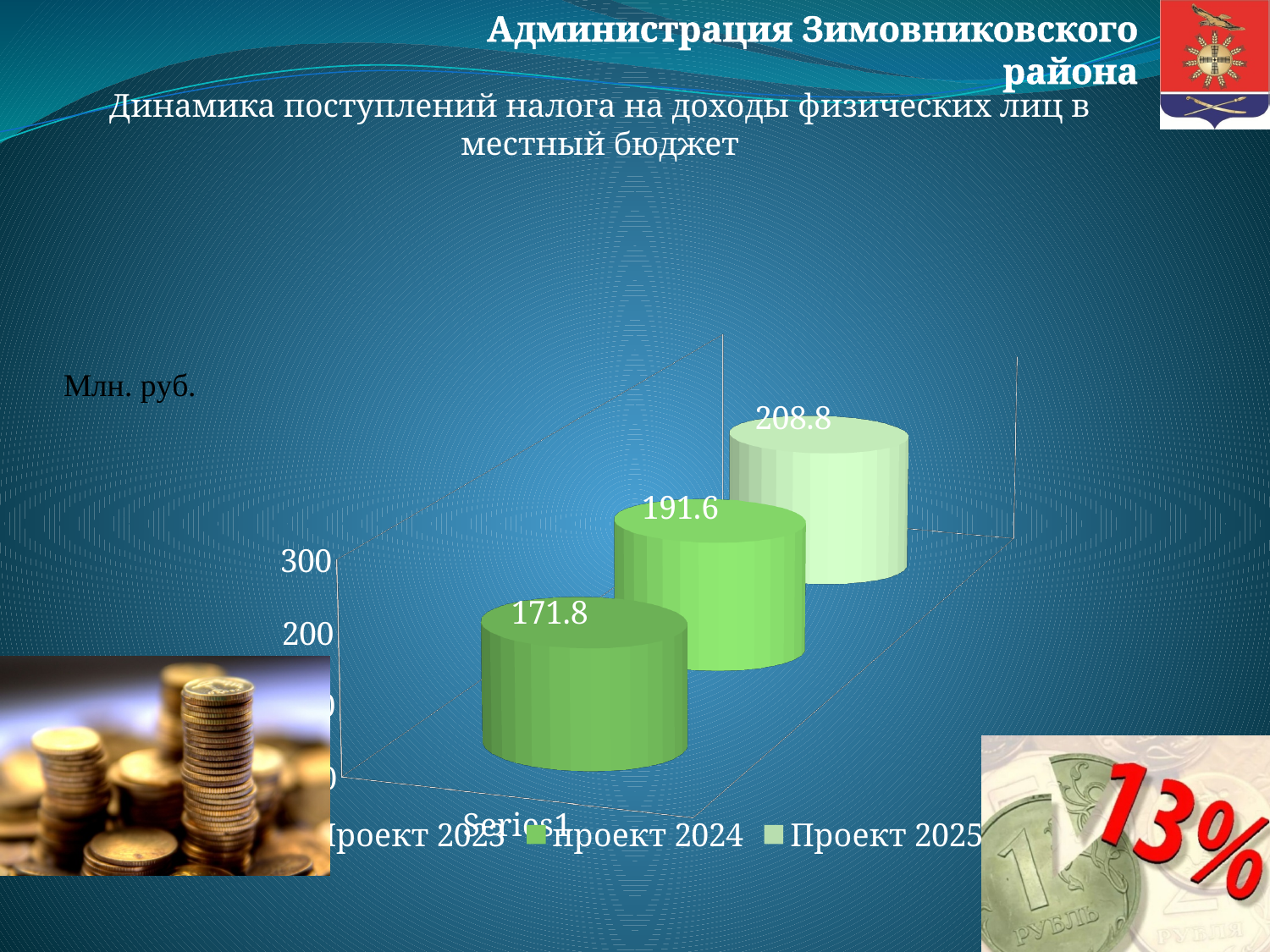
Which series has the highest value? Проект 2025 What unit is indicated for the values on the chart? Млн. руб. How many series does the legend list? 3 Which is larger, the value for Проект 2024 or Проект 2025? Проект 2025 What is the difference between the values for Проект 2024 and Проект 2023? 19.8 What kind of chart is shown on the slide? bar chart Is the value for Проект 2025 greater or less than 200? greater Which series has the lowest value? Проект 2023 What is the value for Проект 2023? 171.8 What is the value for Проект 2025? 208.8 What is the difference between the values for Проект 2025 and Проект 2023? 37 What is the value for Проект 2024? 191.6